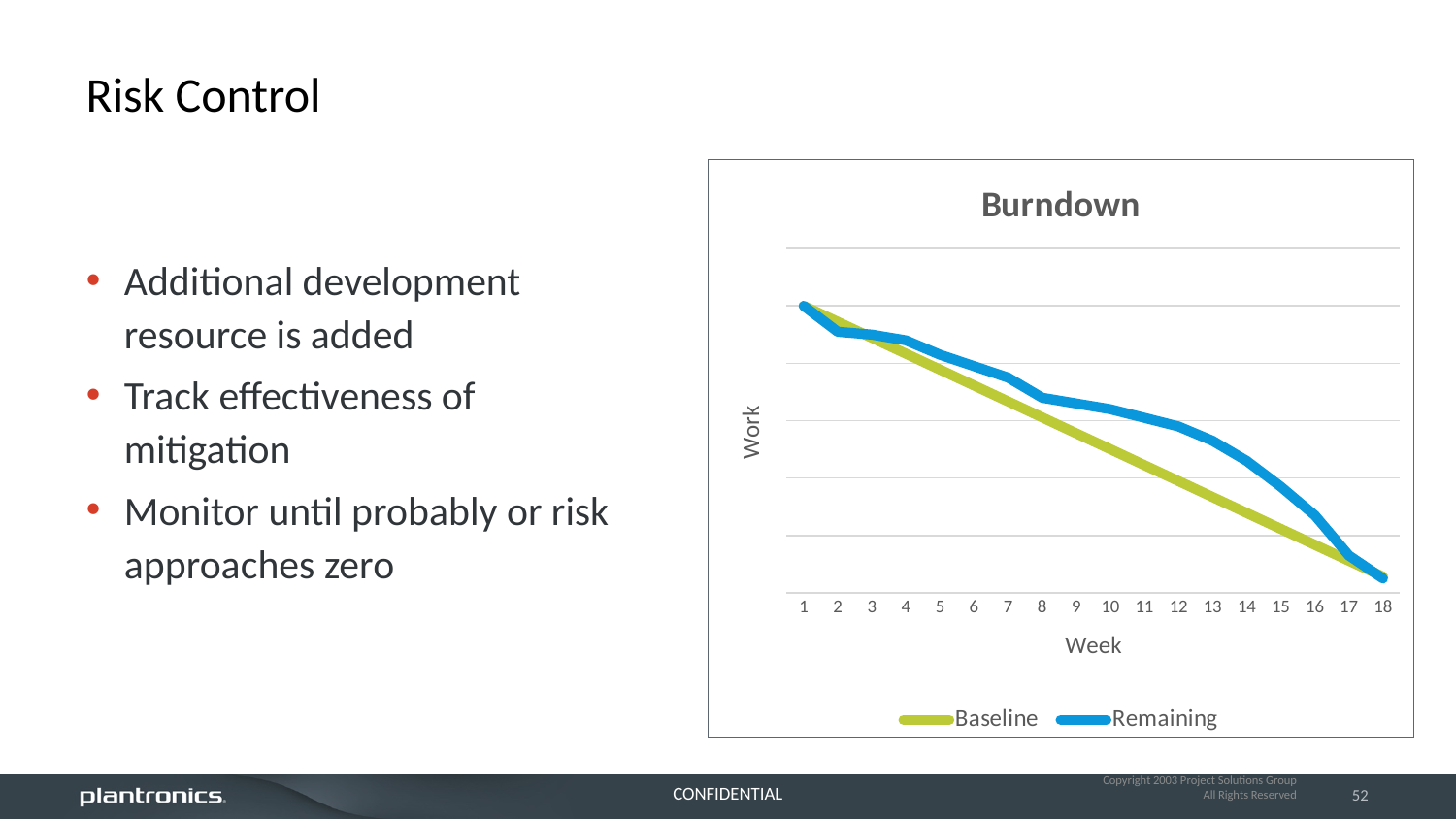
What is the title of the chart? Burndown Which series is drawn in blue in the Burndown chart? Remaining How many weeks are shown along the x axis of the Burndown chart? 18 How many series does the legend list? 2 What is the label of the x axis of the Burndown chart? Week Does the Remaining series trend upward or downward from week 1 to week 18? downward At week 13, is the Remaining line above or below the Baseline line? above What kind of chart is shown on the slide? line chart At which week does the Baseline series have its highest value? 1 Do the values in the Burndown chart rise or fall as the week number increases? fall At week 10, which series has the higher value, Baseline or Remaining? Remaining At which week does the Remaining series reach its lowest value? 18